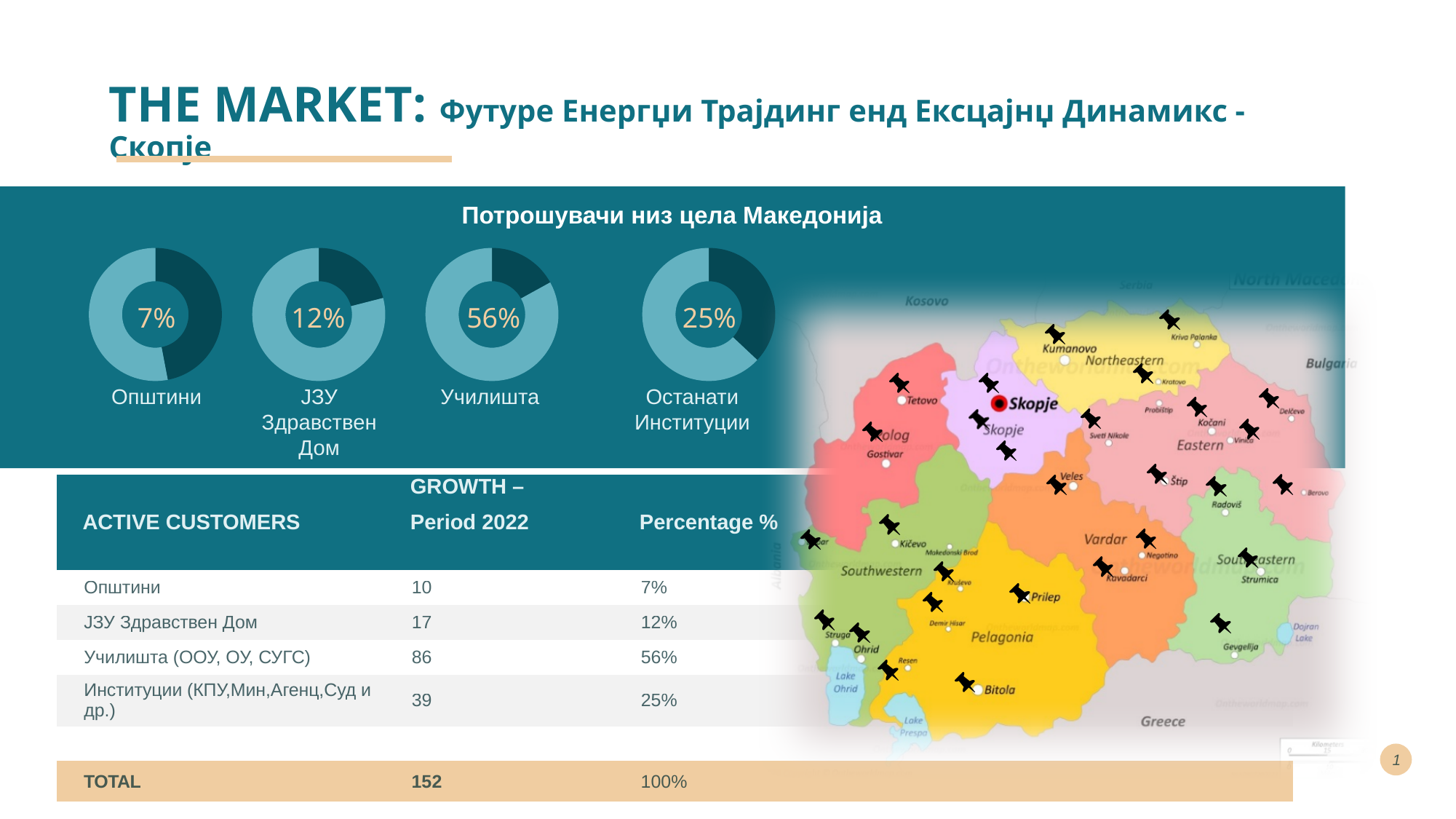
How many donut charts are shown under the heading Потрошувачи низ цела Македонија? 4 What type of chart is used to show the percentages for Општини, ЈЗУ Здравствен Дом, Училишта and Останати Институции? Donut chart What is the difference in percentage points between the Училишта donut chart and the Останати Институции donut chart? 31 What is the difference in percentage points between the Останати Институции donut chart and the ЈЗУ Здравствен Дом donut chart? 13 Which of the four donut charts shows the lowest percentage? Општини What percentage is shown in the donut chart labelled Останати Институции? 25% What percentage is shown in the donut chart labelled Општини? 7% What is the heading above the four donut charts? Потрошувачи низ цела Македонија What percentage is shown in the donut chart labelled Училишта? 56% What percentage is shown in the donut chart labelled ЈЗУ Здравствен Дом? 12% Which shows a larger percentage, the ЈЗУ Здравствен Дом donut chart or the Општини donut chart? ЈЗУ Здравствен Дом Which of the four donut charts shows the highest percentage? Училишта